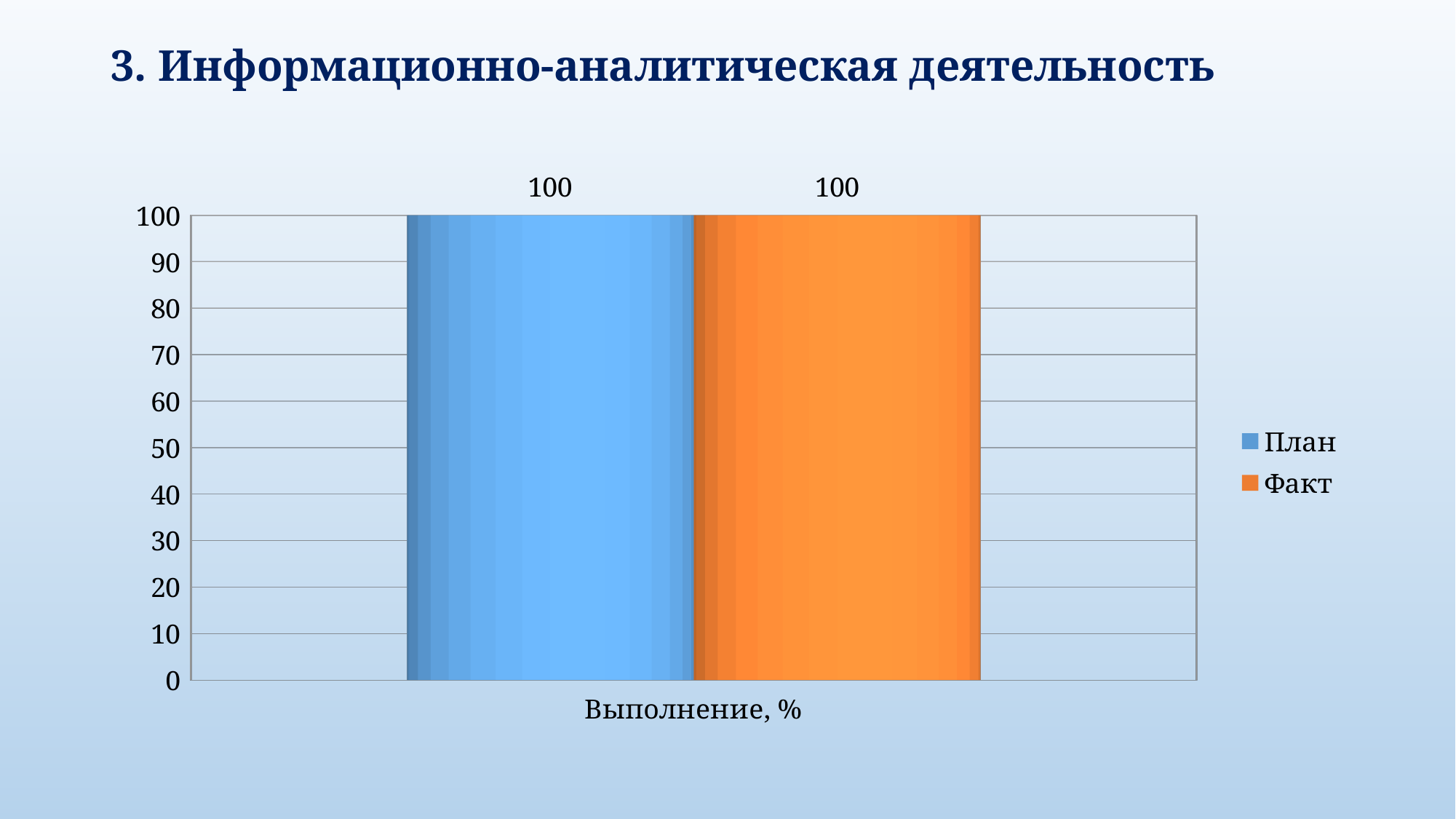
What is the highest value shown on the y axis? 100 What kind of chart is shown on the slide? bar chart What is the value of the Факт series for Выполнение, %? 100 What is the value of the План series for Выполнение, %? 100 How many series does the legend list? 2 Which series is shown in orange? Факт Is the value for План greater or less than 90? greater How many categories are shown on the x axis? 1 Is the value for Факт greater or less than 50? greater What is the label of the category on the x axis? Выполнение, % What is the difference between the План and Факт values for Выполнение, %? 0